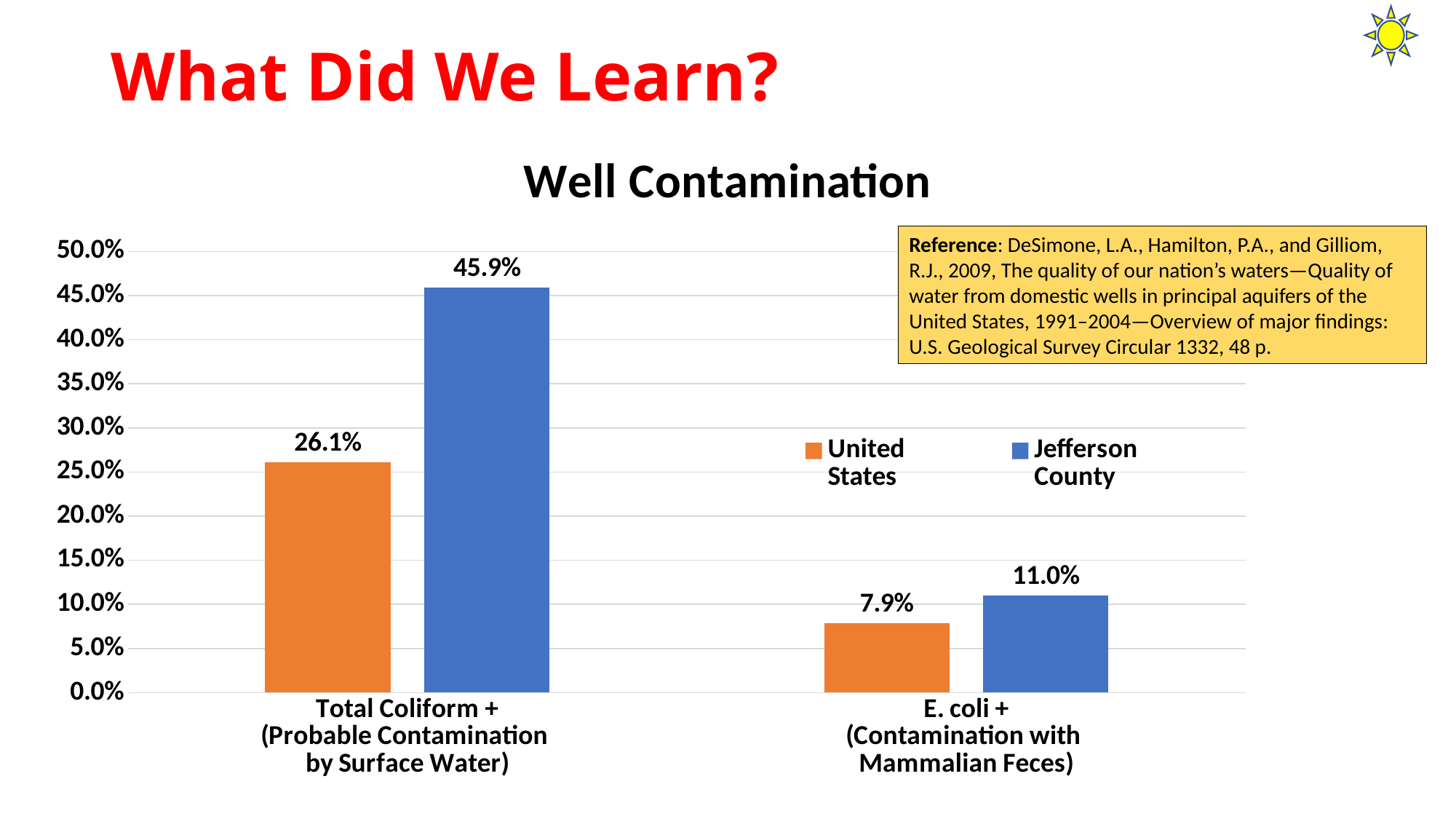
Which bar in the chart has the lowest value? United States, E. coli + What is the difference between the Jefferson County and United States values for Total Coliform +? 19.8% What is the United States value for Total Coliform +? 26.1% What is the title of the chart? Well Contamination What is the difference between the Jefferson County and United States values for E. coli +? 3.1% For E. coli +, which is larger: United States or Jefferson County? Jefferson County What is the United States value for E. coli +? 7.9% What is the Jefferson County value for E. coli +? 11.0% Which bar in the chart has the highest value? Jefferson County, Total Coliform + How many series does the legend list? 2 What is the Jefferson County value for Total Coliform +? 45.9% What kind of chart is shown on the slide? Bar chart